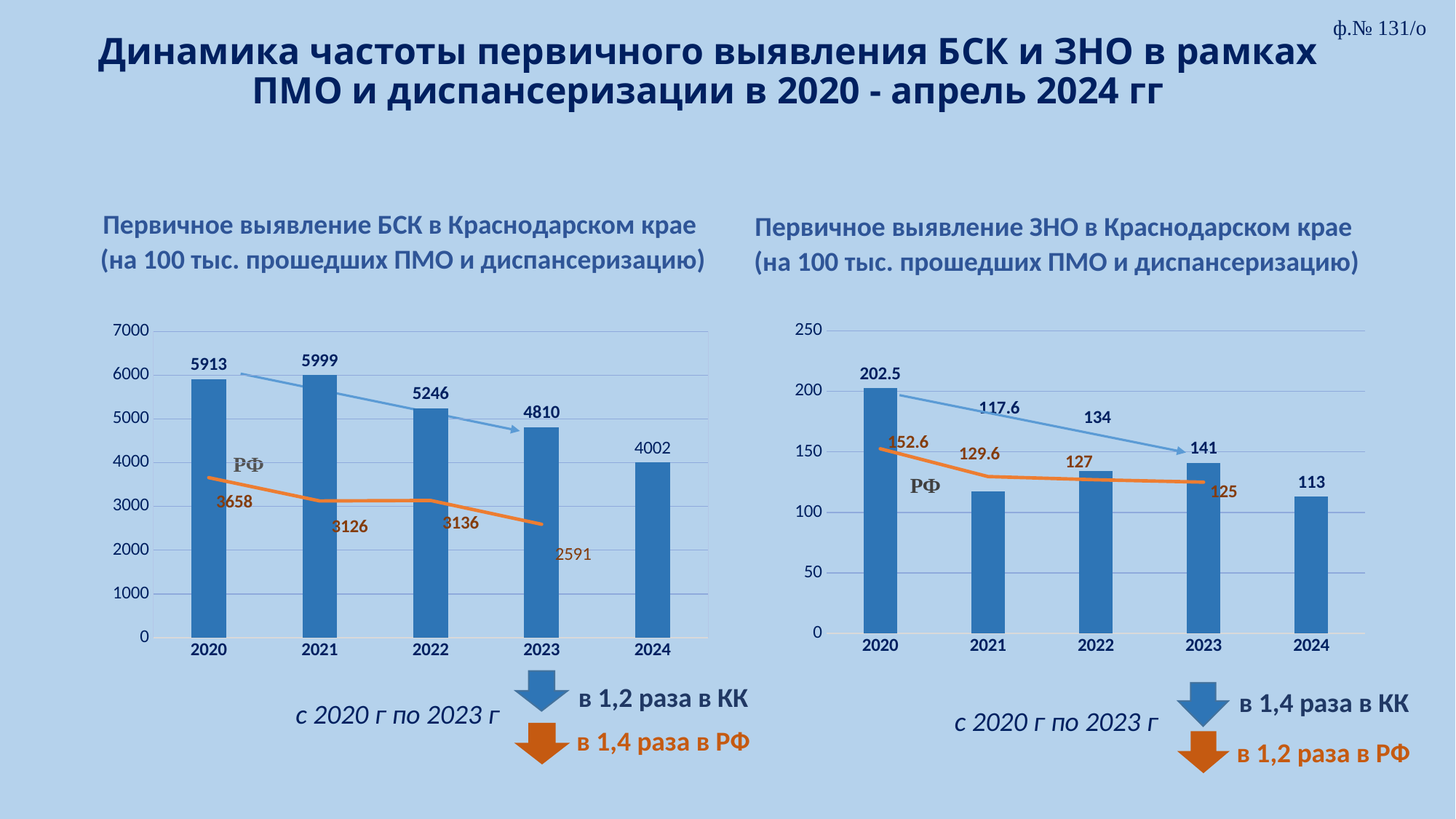
On the left chart (Первичное выявление БСК в Краснодарском крае), what is the bar value for 2021? 5999 On the right chart (Первичное выявление ЗНО в Краснодарском крае), which year has the lowest bar? 2024 On the left chart (Первичное выявление БСК в Краснодарском крае), which year has the lowest bar? 2024 On the left chart (Первичное выявление БСК в Краснодарском крае), which year has the highest bar? 2021 On the right chart (Первичное выявление ЗНО в Краснодарском крае), which is larger, the bar value for 2022 or for 2023? 2023 On the right chart (Первичное выявление ЗНО в Краснодарском крае), what is the bar value for 2020? 202.5 On the left chart (Первичное выявление БСК в Краснодарском крае), how many years are shown on the x axis? 5 What kind of chart is the left chart (Первичное выявление БСК в Краснодарском крае)? bar chart with a line On the right chart (Первичное выявление ЗНО в Краснодарском крае), do the bar values rise or fall from 2020 to 2021? fall On the right chart (Первичное выявление ЗНО в Краснодарском крае), what is the value of the РФ line for 2021? 129.6 On the left chart (Первичное выявление БСК в Краснодарском крае), what is the value of the РФ line for 2023? 2591 On the left chart (Первичное выявление БСК в Краснодарском крае), what is the difference between the bar values for 2020 and 2023? 1103